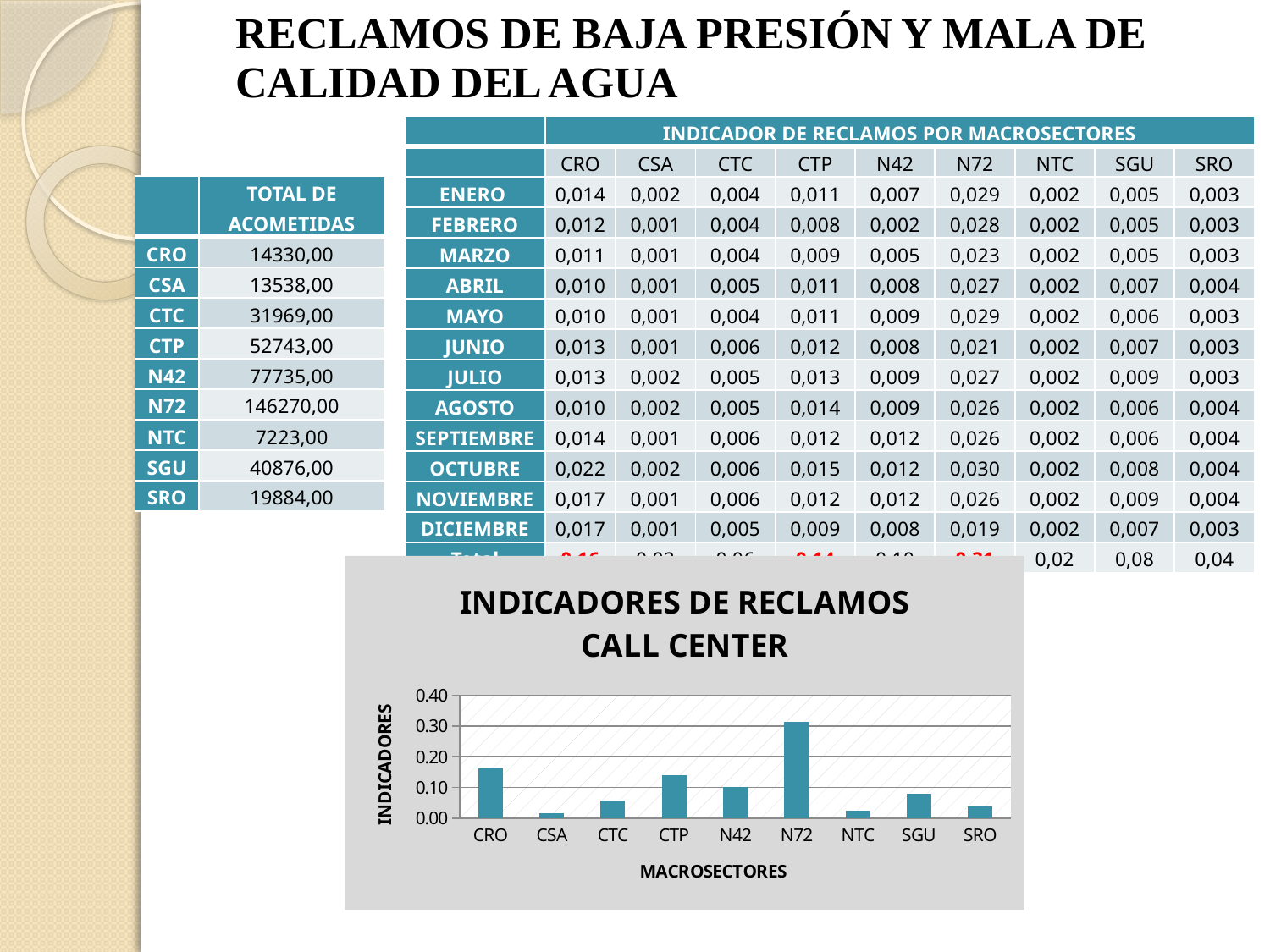
In the "INDICADORES DE RECLAMOS CALL CENTER" chart, is the value for CRO greater or less than 0.10? greater In the "INDICADORES DE RECLAMOS CALL CENTER" chart, is the value for N72 greater or less than 0.20? greater What is the label on the y axis of the "INDICADORES DE RECLAMOS CALL CENTER" chart? INDICADORES In the "INDICADORES DE RECLAMOS CALL CENTER" chart, is the value for CTP greater or less than 0.10? greater How many macrosectors are plotted on the x axis of the "INDICADORES DE RECLAMOS CALL CENTER" chart? 9 In the "INDICADORES DE RECLAMOS CALL CENTER" chart, which macrosector has the highest indicator value? N72 What is the label on the x axis of the "INDICADORES DE RECLAMOS CALL CENTER" chart? MACROSECTORES In the "INDICADORES DE RECLAMOS CALL CENTER" chart, which is larger, the value for N72 or the value for CRO? N72 In the "INDICADORES DE RECLAMOS CALL CENTER" chart, which is larger, the value for N42 or the value for CSA? N42 What kind of chart is shown under the title "INDICADORES DE RECLAMOS CALL CENTER"? bar chart